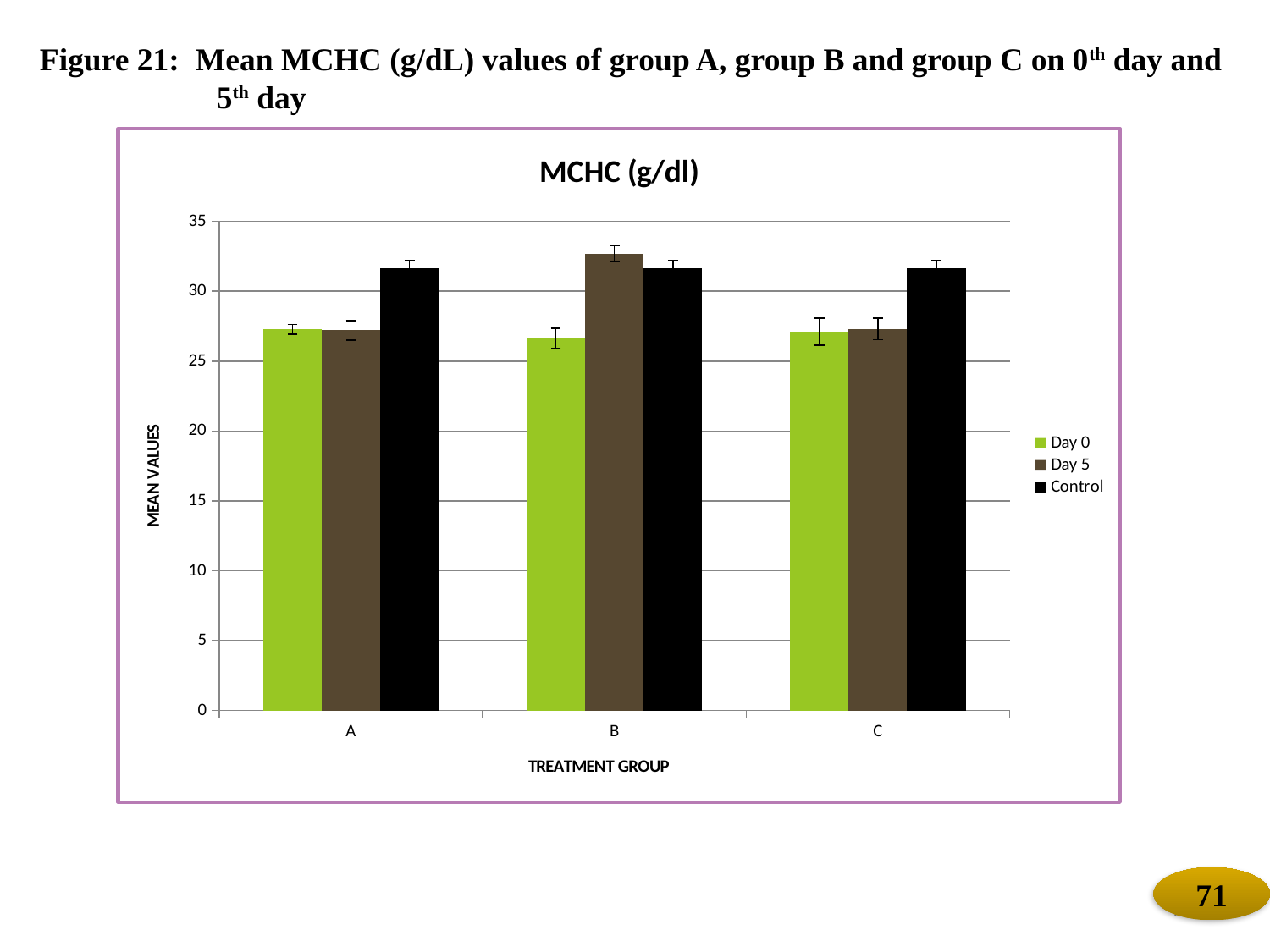
Is the Day 5 value for group C greater or less than 25? greater How many treatment groups are shown on the x axis? 3 What is the title of the chart? MCHC (g/dl) What kind of chart is shown on the slide? bar chart Which series has the highest value for group B? Day 5 Is the Day 0 value for group B greater or less than 30? less For group A, which is larger, the Day 0 value or the Control value? Control How many series does the legend list? 3 What are the series names listed in the legend? Day 0, Day 5, Control For group B, which is larger, the Day 0 value or the Day 5 value? Day 5 Is the Control value for group A greater or less than 30? greater